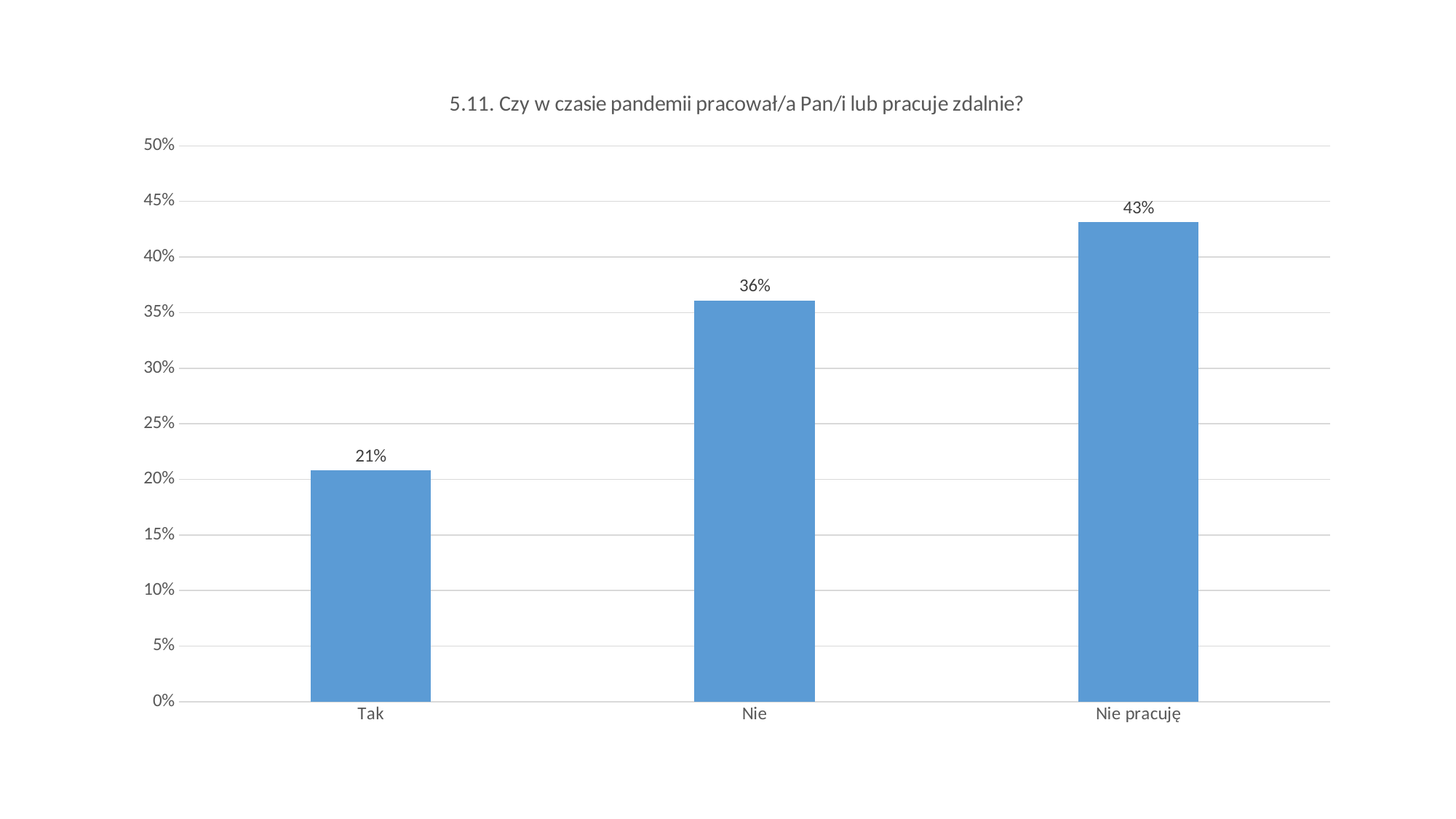
Is the value for "Nie pracuję" greater or less than 40%? greater What is the difference between the values for "Nie" and "Tak"? 15% Which category has the highest value? Nie pracuję Which is larger, the value for "Tak" or the value for "Nie"? Nie What is the difference between the values for "Nie pracuję" and "Nie"? 7% What is the value for "Tak"? 21% Which category has the lowest value? Tak Do the values rise or fall from left to right along the x axis? rise What kind of chart is shown on the slide? bar chart What is the value for "Nie pracuję"? 43% What is the value for "Nie"? 36% How many categories are shown on the x axis? 3